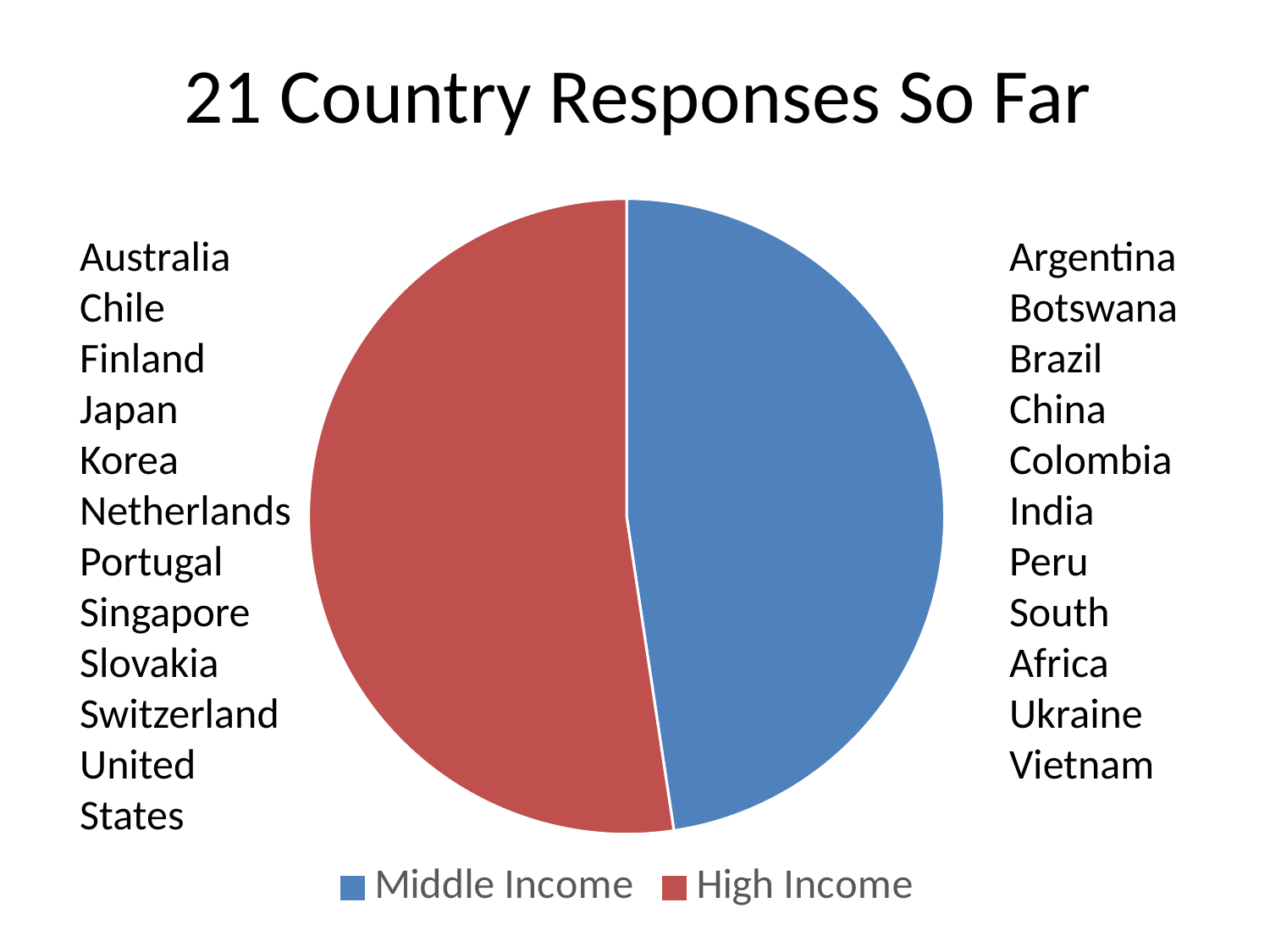
Which colour represents Middle Income in the pie chart? blue How many entries does the legend of the pie chart list? 2 What kind of chart is shown on the slide? pie chart What is the title of the slide containing the pie chart? 21 Country Responses So Far Which category has the largest slice in the pie chart? High Income Which slice of the pie chart is larger, Middle Income or High Income? High Income Which category has the smallest slice in the pie chart? Middle Income How many slices does the pie chart have? 2